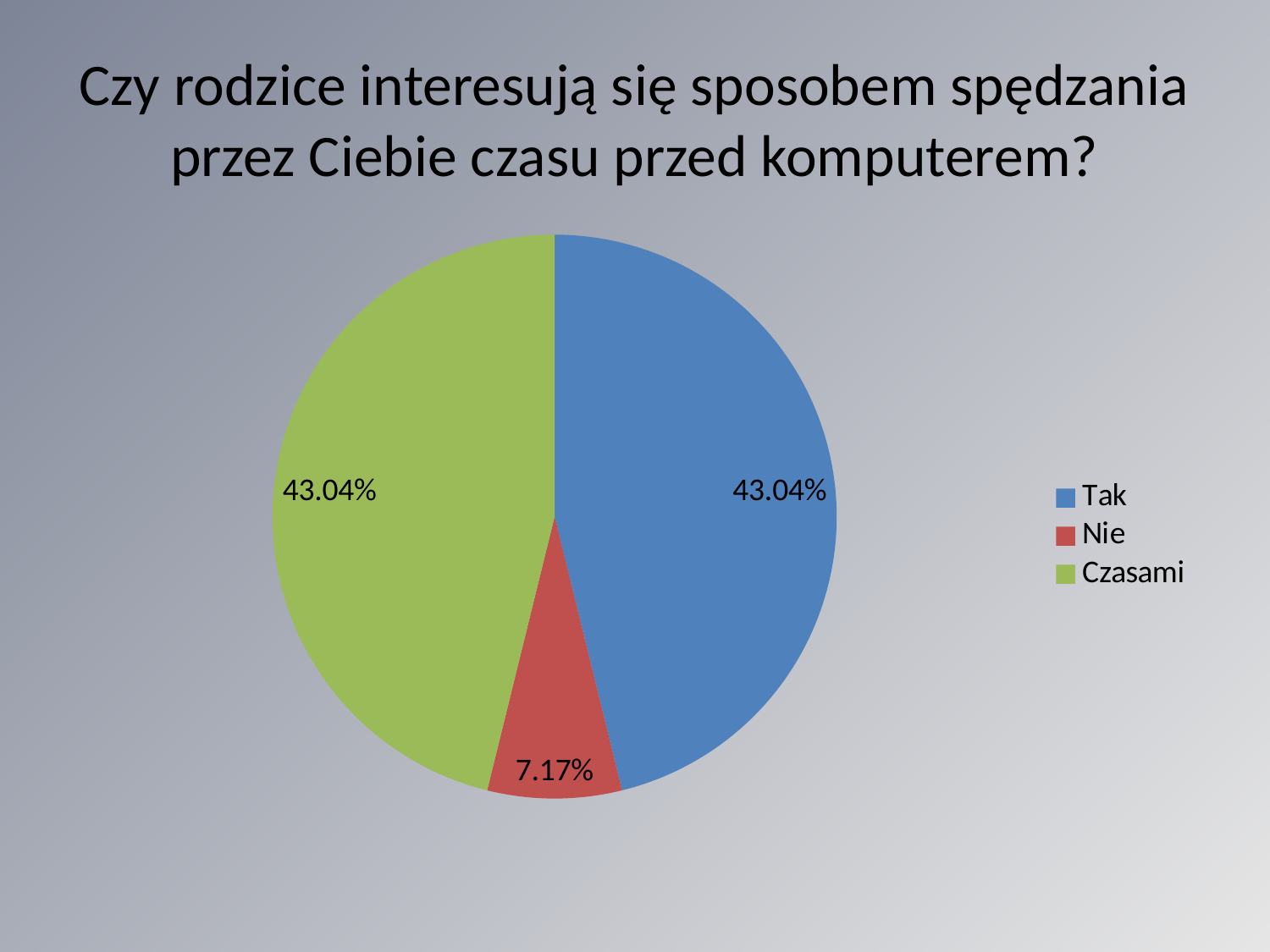
Which category has the smallest slice of the pie? Nie What is the value shown for the "Tak" slice? 43.04% What is the value shown for the "Czasami" slice? 43.04% Which colour represents "Czasami" in the legend? green What share of the pie does the "Nie" slice represent? 7.17% What kind of chart is shown on the slide? pie chart What is the difference between the values for "Tak" and "Nie"? 35.87% Which is larger, the slice for "Czasami" or the slice for "Nie"? Czasami Which is larger, the slice for "Tak" or the slice for "Nie"? Tak How many slices does the pie chart have? 3 How many entries does the legend list? 3 What is the value shown for the "Nie" slice? 7.17%